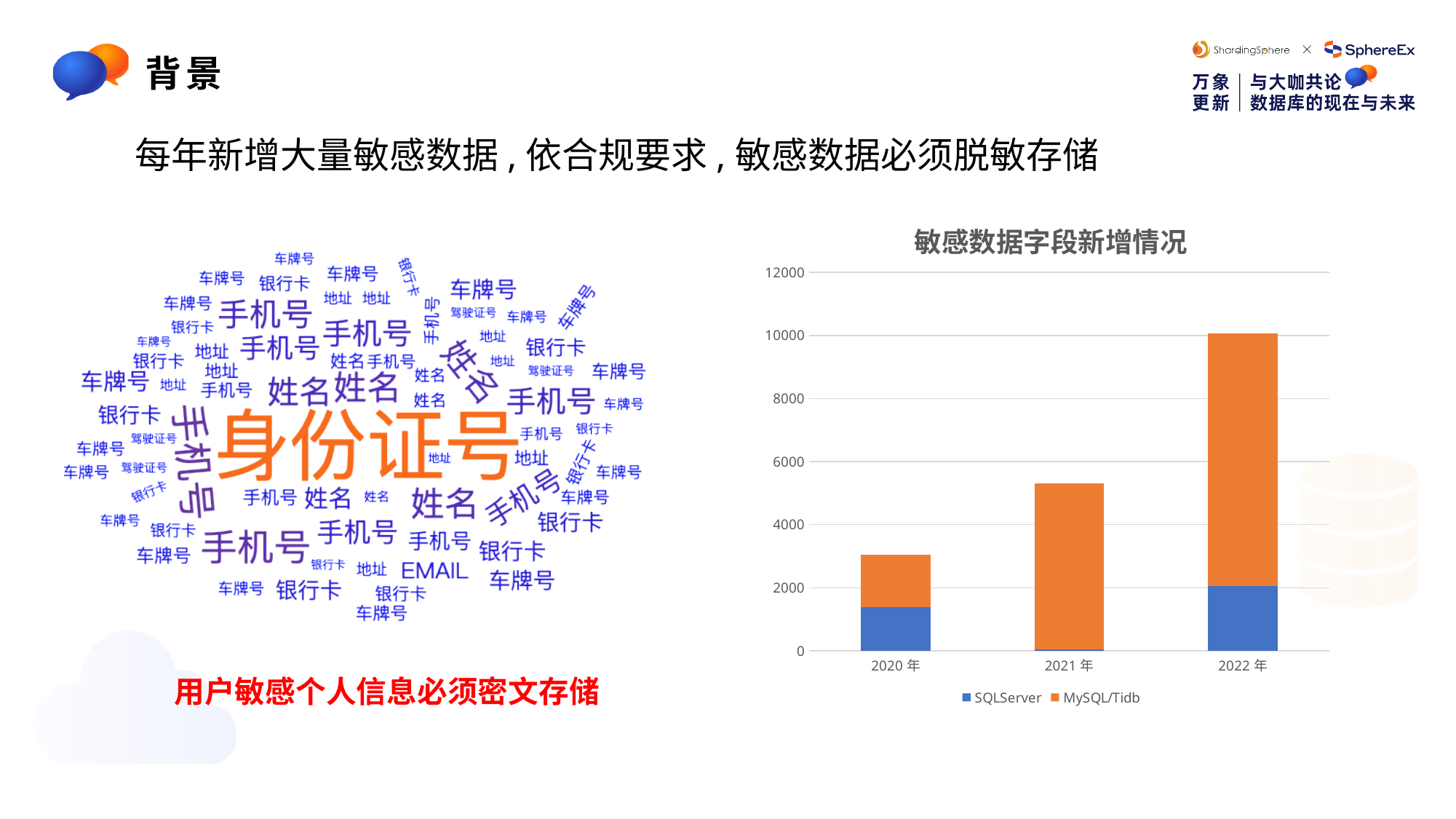
Is the total value for 2021 年 greater or less than 6000? less Which colour represents the MySQL/Tidb series in the chart? orange How many series does the chart legend list? 2 Which year has the tallest stacked bar in the chart? 2022 年 Which year has the shortest stacked bar in the chart? 2020 年 What is the title of the chart? 敏感数据字段新增情况 Which is larger, the total bar for 2021 年 or the total bar for 2022 年? 2022 年 How many year categories are shown on the x axis of the chart? 3 Do the total bar heights rise or fall from 2020 年 to 2022 年? rise Is the total value for 2020 年 greater or less than 2000? greater Is the total value for 2022 年 greater or less than 8000? greater What kind of chart is shown on the slide? stacked bar chart